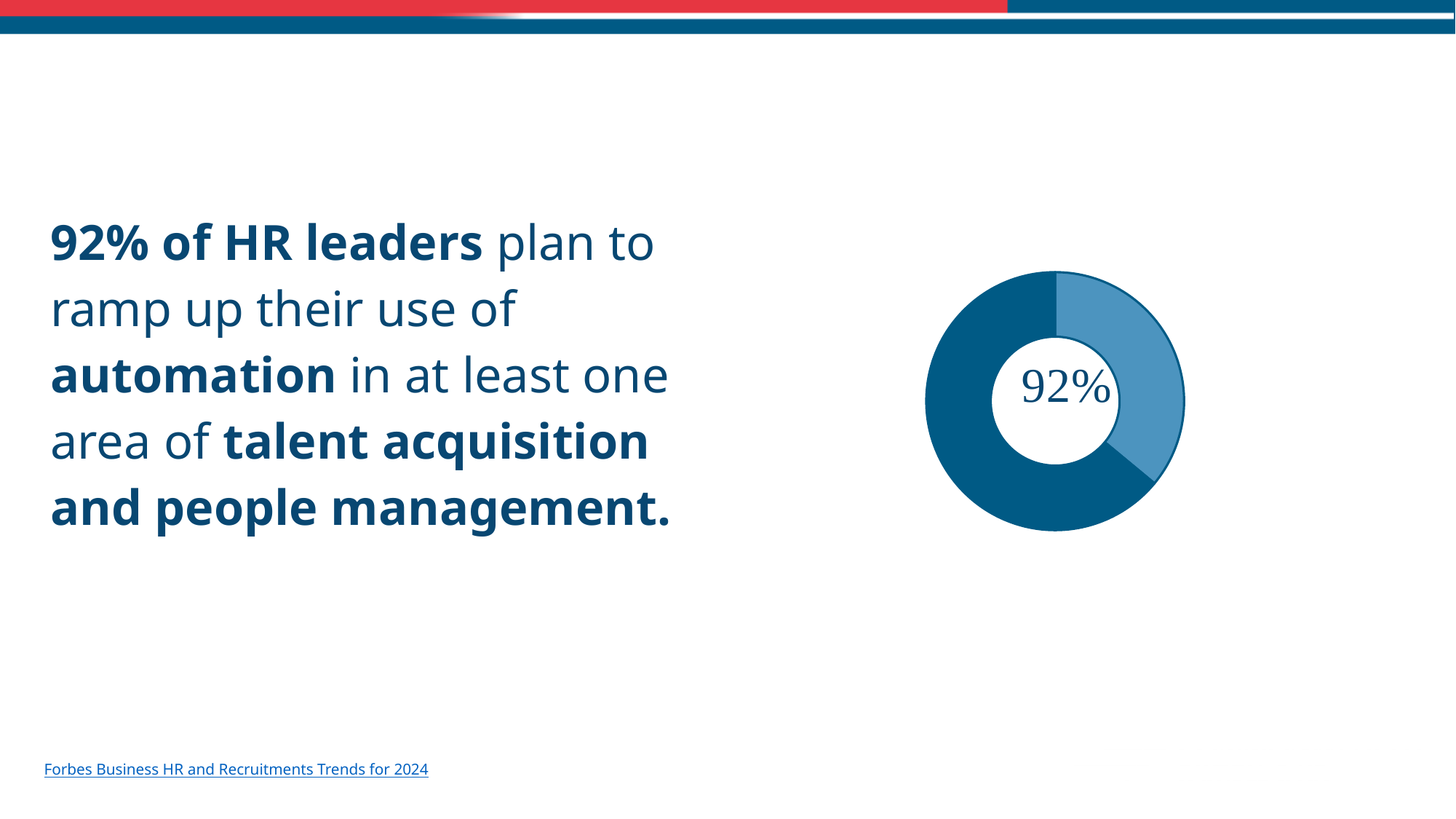
What kind of chart is shown on the slide? donut chart How many slices does the donut chart have? 2 Which slice of the donut chart is larger, the dark blue one or the light blue one? dark blue According to the slide, what percentage of HR leaders plan to ramp up their use of automation? 92% What value is printed in the centre of the donut chart? 92% What two colours are used for the slices of the donut chart? dark blue and light blue What source is cited at the bottom of the slide for the chart's statistic? Forbes Business HR and Recruitments Trends for 2024 Does the dark blue slice of the donut chart cover more or less than half of the ring? more